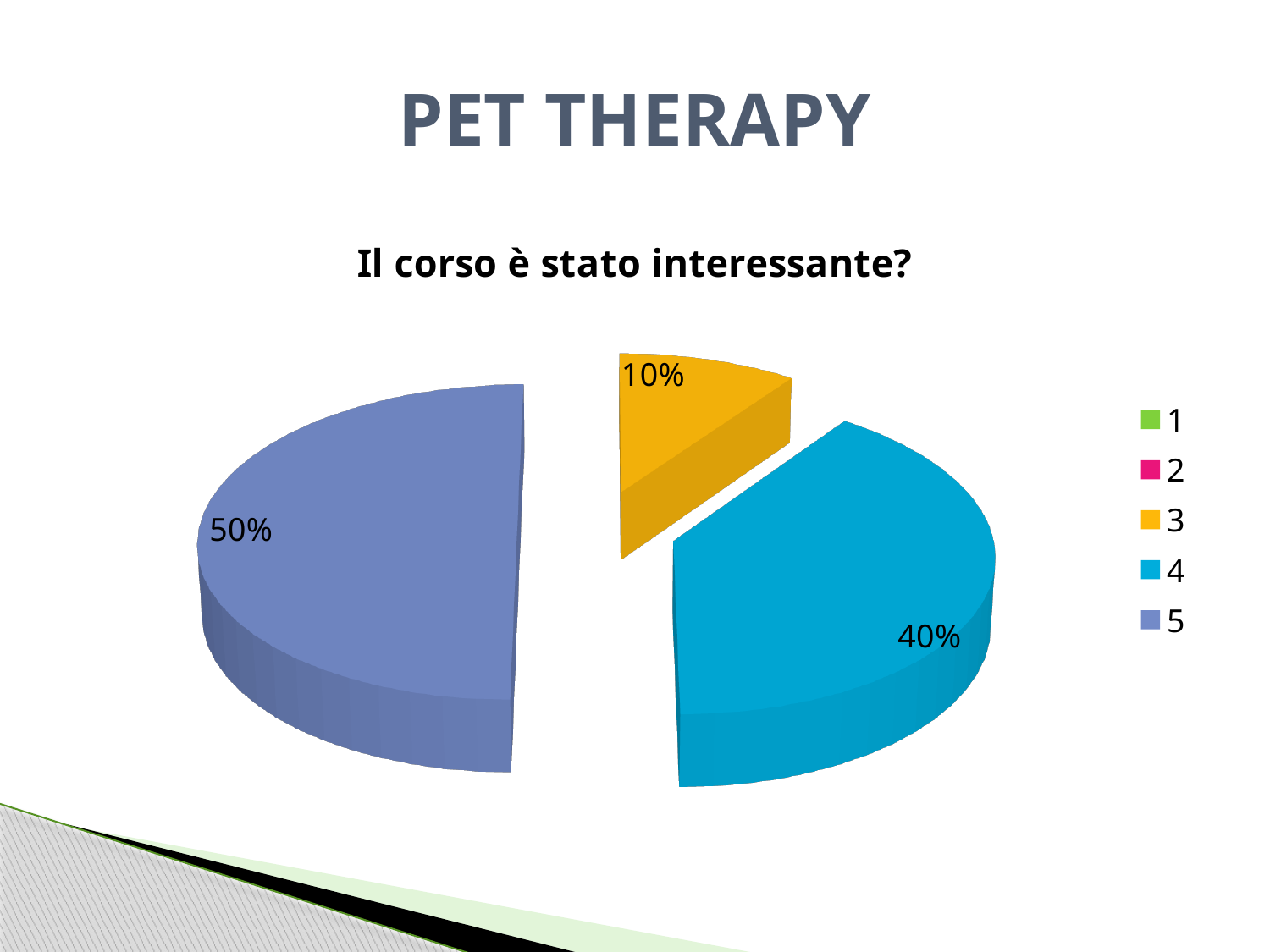
What is the difference between the shares of category 4 and category 3? 30% What colour is the slice for category 3? yellow What is the title of the chart? Il corso è stato interessante? Which category has the largest slice of the pie? 5 Which is larger, the share of category 4 or the share of category 3? 4 What share of the pie does category 3 have? 10% How many entries does the legend list? 5 What share of the pie does category 5 have? 50% What share of the pie does category 4 have? 40% What is the difference between the shares of category 5 and category 4? 10% What kind of chart is shown on the slide? pie chart Which category has the smallest visible slice of the pie? 3